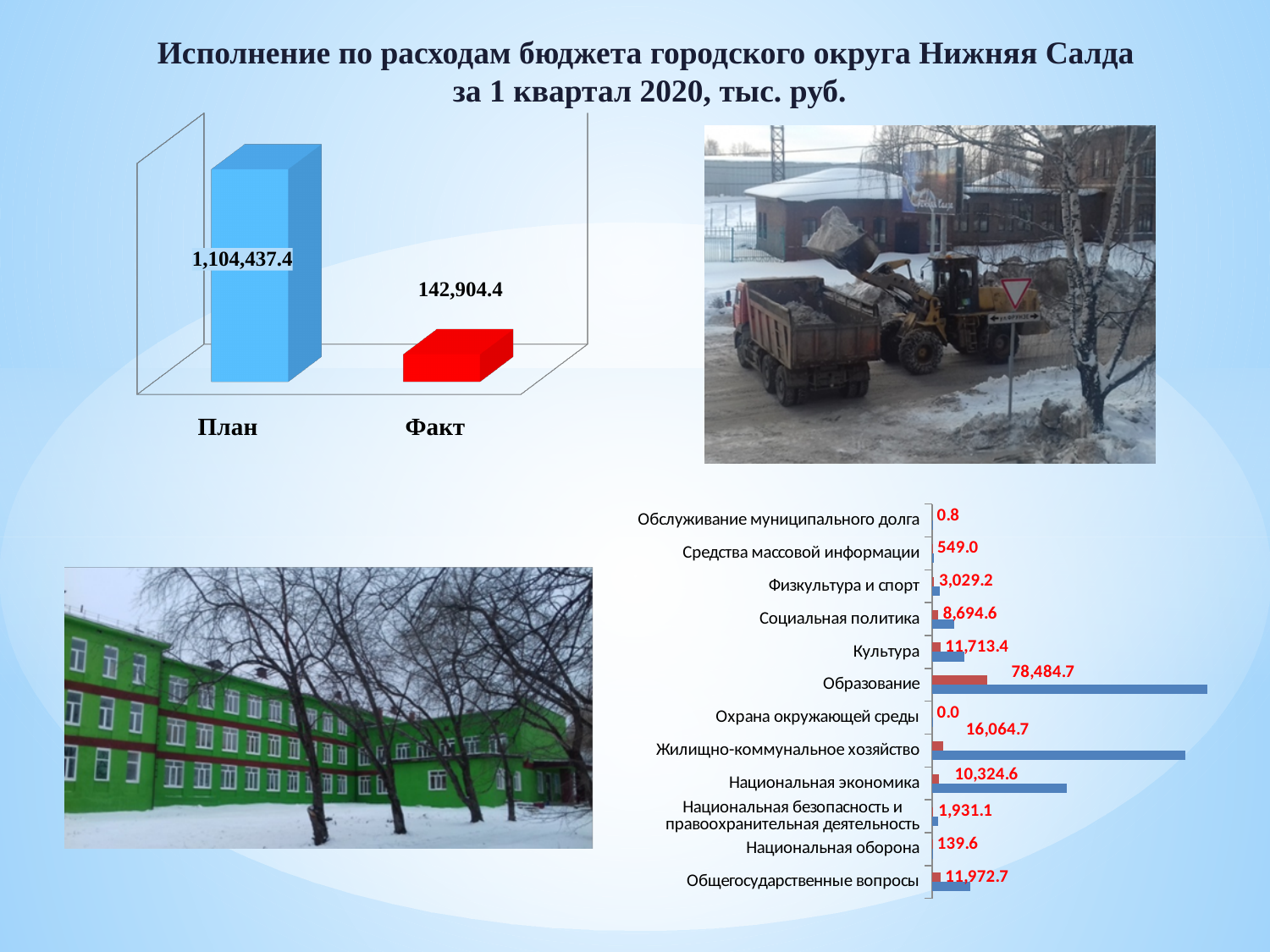
In the top-left chart, what is the difference between План and Факт? 961,533.0 In the bottom-right chart, which category has the highest labelled value? Образование In the bottom-right chart, what is the difference between the labelled values for Жилищно-коммунальное хозяйство and Национальная экономика? 5,740.1 In the bottom-right chart, which category has the lowest labelled value? Охрана окружающей среды In the bottom-right chart, how many categories are listed? 12 What kind of chart is the top-left chart? Bar chart In the bottom-right chart, what is the labelled value for Образование? 78,484.7 In the top-left chart, what is the value for Факт? 142,904.4 In the top-left chart, how many categories are shown? 2 In the top-left chart, what is the value for План? 1,104,437.4 In the bottom-right chart, what is the labelled value for Национальная оборона? 139.6 In the top-left chart, which is larger, План or Факт? План